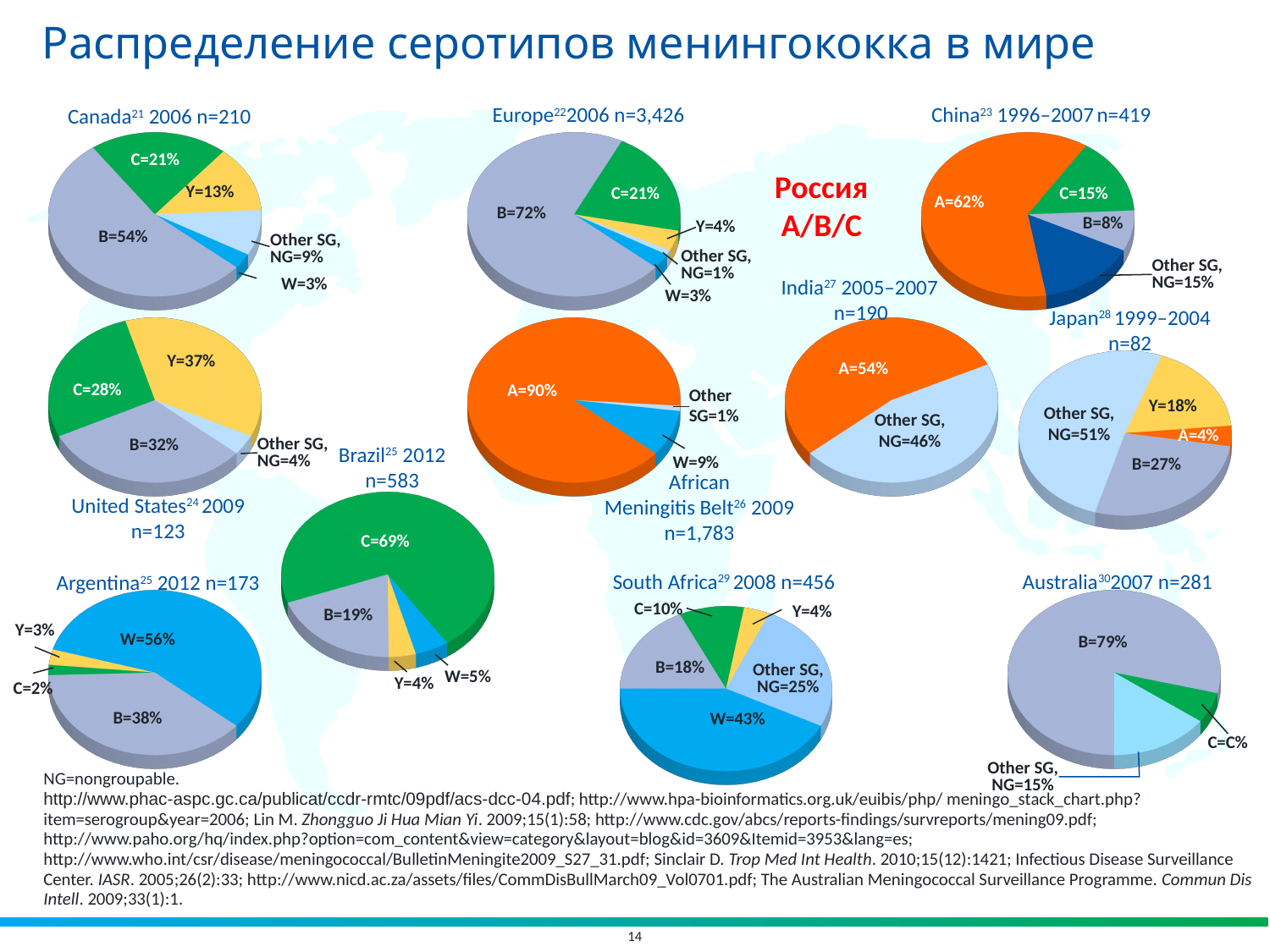
In the Canada 2006 pie chart, what share is serogroup B? 54% In the Brazil 2012 pie chart, what share is serogroup C? 69% In the China 1996–2007 pie chart, what share is serogroup A? 62% In the South Africa 2008 pie chart, how many slices are there? 5 In the Japan 1999–2004 pie chart, which serogroup has the smallest share? A What type of chart is used for the Australia 2007 data? Pie chart In the Argentina 2012 pie chart, which is larger, serogroup W or serogroup B? W In the Europe 2006 pie chart, which serogroup has the largest share? B In the India 2005–2007 pie chart, what is the difference between serogroup A and Other SG, NG? 8% In the African Meningitis Belt 2009 pie chart, what share is serogroup W? 9% In the United States 2009 pie chart, what is the difference between serogroup Y and serogroup C? 9% What is the sample size (n) shown for the Europe 2006 chart? 3,426